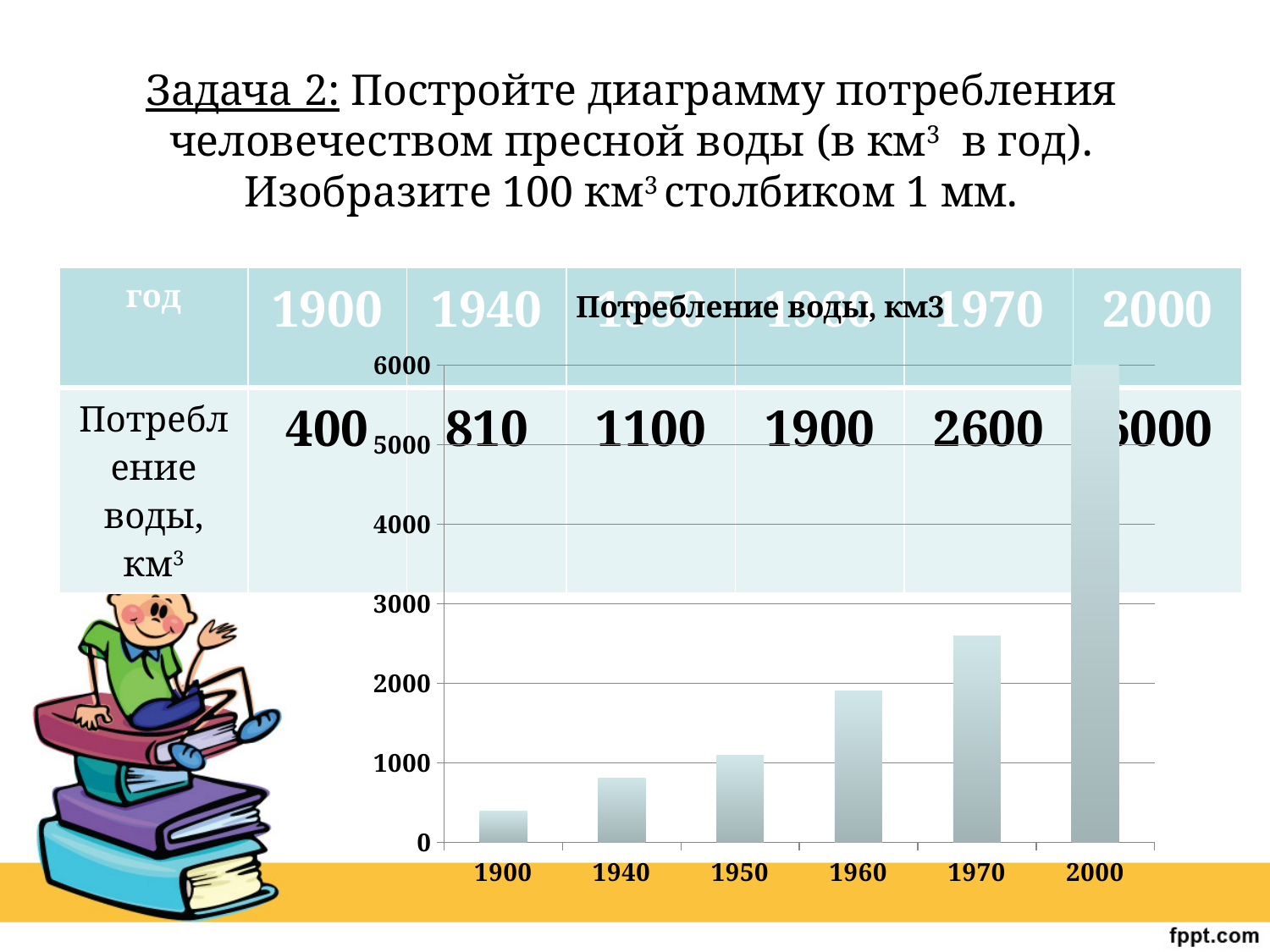
Is the value for 1960 greater or less than 2000? less What is the value of the bar for 2000? 6000 Do the values rise or fall from 1900 to 2000 along the x axis? rise How many years are plotted on the chart? 6 Is the value for 1940 greater or less than 1000? less Which year has the highest water consumption on the chart? 2000 Which year has the lowest water consumption on the chart? 1900 Is the value for 1950 greater or less than 1000? greater What is the title of the chart? Потребление воды, км3 What kind of chart is shown on the slide? bar chart Which year has the larger bar, 1950 or 1960? 1960